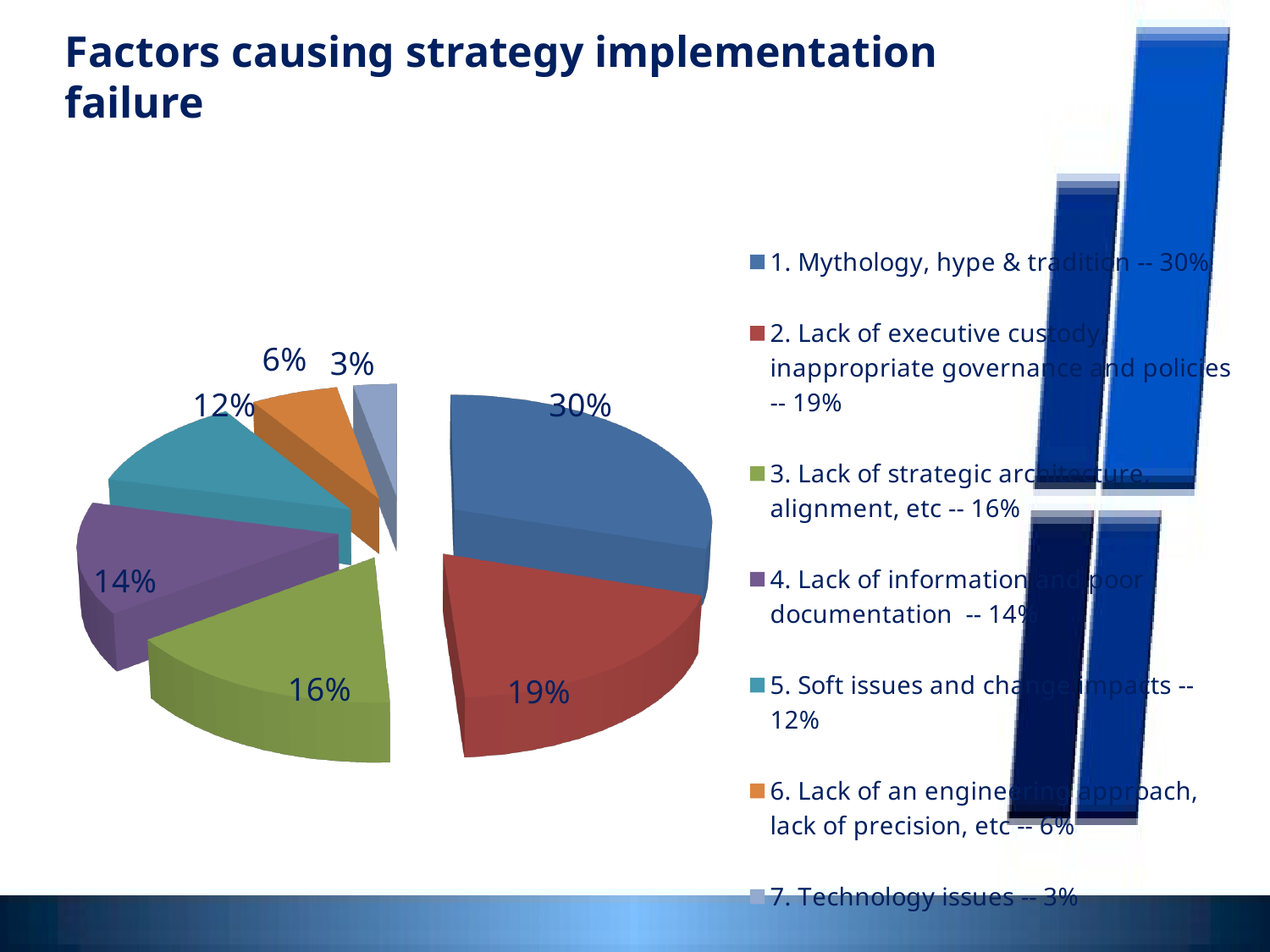
What percentage is shown for "Technology issues"? 3% Which factor has the smallest share of the pie? 7. Technology issues Which is larger: the share for "Lack of strategic architecture, alignment, etc" or the share for "Lack of information and poor documentation"? Lack of strategic architecture, alignment, etc How many slices does the pie chart have? 7 What percentage is shown for "Soft issues and change impacts"? 12% What kind of chart is shown on the slide? Pie chart What is the difference in percentage points between "Mythology, hype & tradition" and "Lack of executive custody, inappropriate governance and policies"? 11 What percentage is shown for "Mythology, hype & tradition"? 30% Which factor has the largest share of the pie? 1. Mythology, hype & tradition What colour is the slice representing "Lack of an engineering approach, lack of precision, etc"? Orange What is the title of the slide containing the pie chart? Factors causing strategy implementation failure What percentage is shown for "Lack of information and poor documentation"? 14%